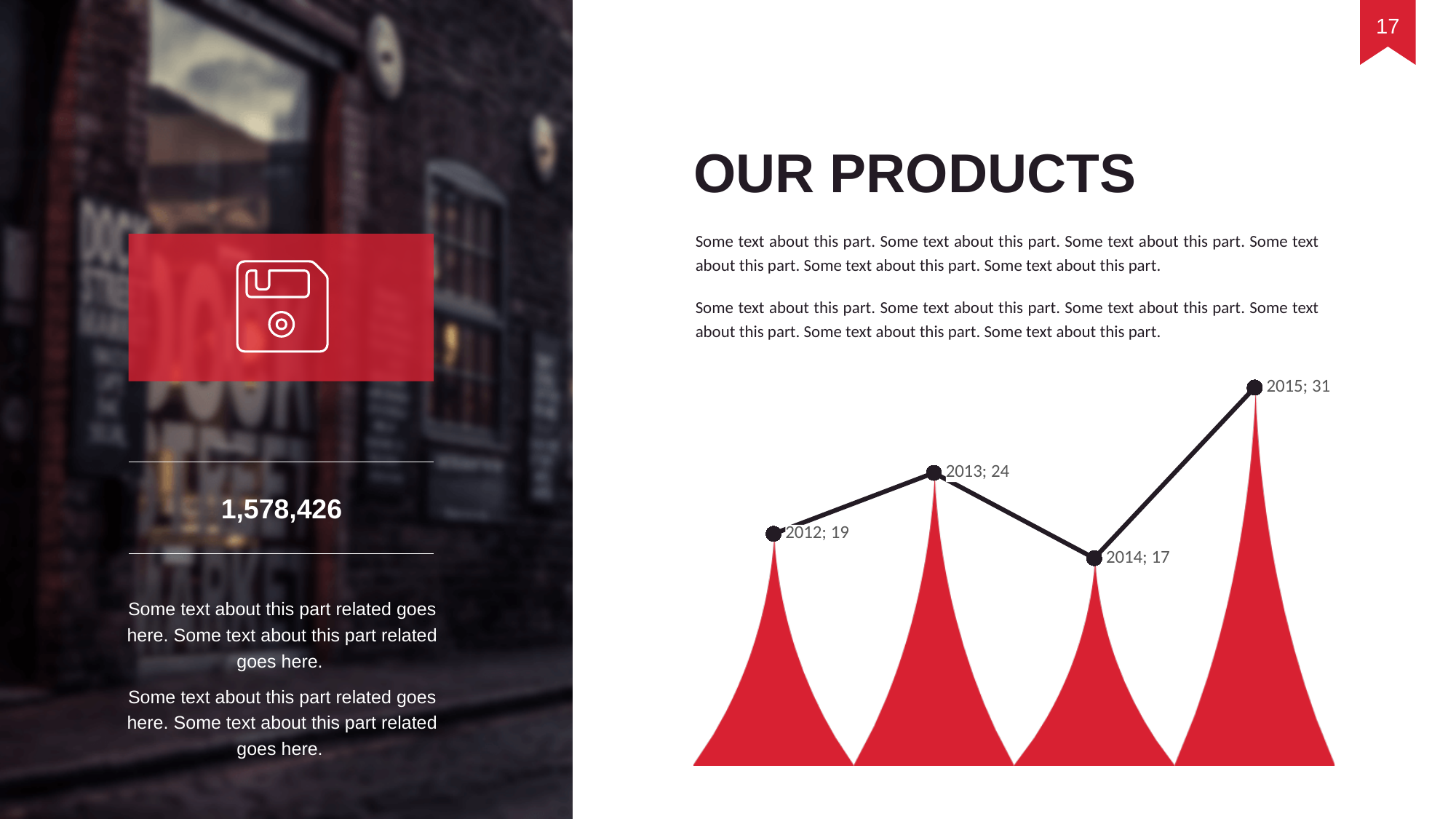
Which is larger, the value for 2013 or the value for 2014? 2013 What is the value for 2012? 19 What is the value for 2013? 24 Which year has the lowest value? 2014 How many data points are plotted on the chart? 4 Which year has the highest value? 2015 What is the difference between the values for 2015 and 2014? 14 What kind of chart is shown on the slide? combination line and bar chart What is the value for 2015? 31 Does the value rise or fall from 2013 to 2014? fall What is the difference between the values for 2013 and 2012? 5 What is the value for 2014? 17